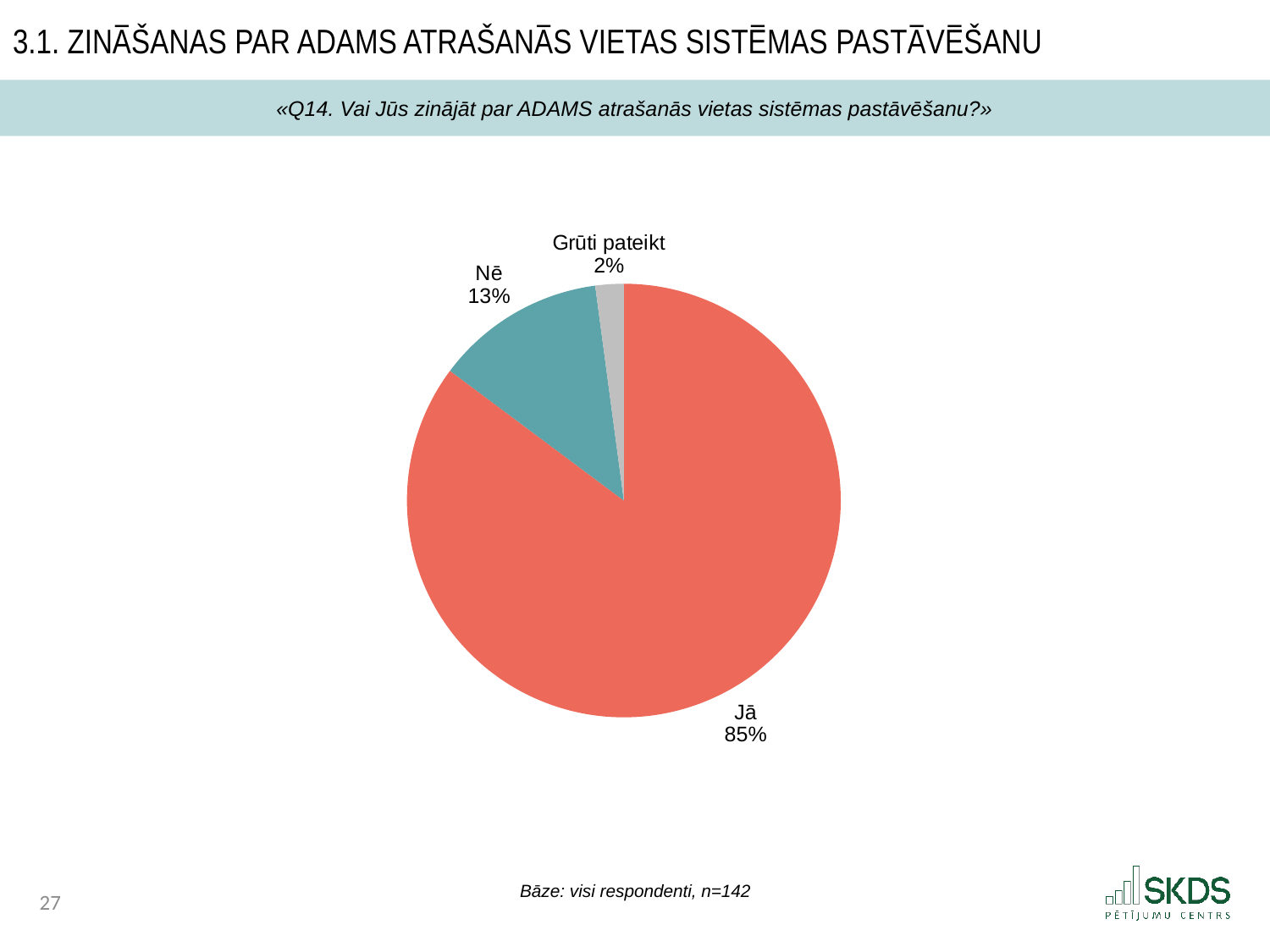
What share of respondents answered "Jā"? 85% What share of respondents answered "Nē"? 13% What colour is the "Jā" slice? red What share of respondents answered "Grūti pateikt"? 2% What kind of chart is shown on the slide? pie chart Which answer has the largest slice of the pie? Jā What is the difference in percentage points between "Jā" and "Nē"? 72 What is the difference in percentage points between "Nē" and "Grūti pateikt"? 11 Which is larger, the share for "Nē" or the share for "Grūti pateikt"? Nē Which answer has the smallest slice of the pie? Grūti pateikt How many slices does the pie chart have? 3 What is the base (n) stated below the chart? n=142